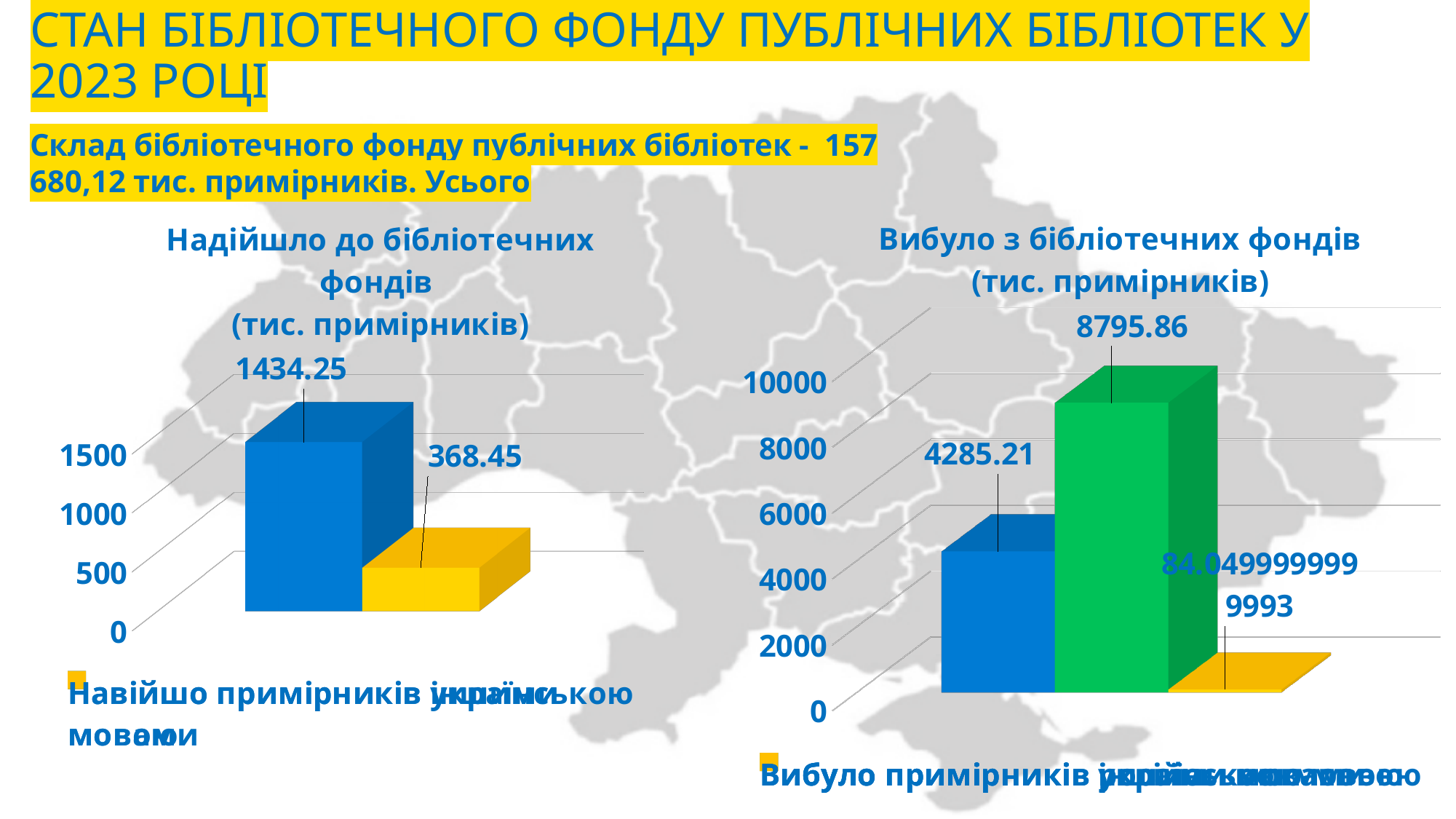
In the right chart (Вибуло з бібліотечних фондів), what is the difference between the green bar and the blue bar? 4510.65 What type of chart is the left chart (Надійшло до бібліотечних фондів)? Bar chart In the right chart (Вибуло з бібліотечних фондів), is the value of the yellow bar greater or less than 2000? less In the left chart (Надійшло до бібліотечних фондів), what is the value of the yellow bar? 368.45 In the left chart (Надійшло до бібліотечних фондів), how many bars are plotted? 2 In the right chart (Вибуло з бібліотечних фондів), how many bars are plotted? 3 In the left chart (Надійшло до бібліотечних фондів), what is the value of the blue bar? 1434.25 In the right chart (Вибуло з бібліотечних фондів), which coloured bar is the lowest? Yellow In the right chart (Вибуло з бібліотечних фондів), what is the value of the green bar? 8795.86 In the left chart (Надійшло до бібліотечних фондів), what is the difference between the blue bar and the yellow bar? 1065.80 In the right chart (Вибуло з бібліотечних фондів), what is the value of the blue bar? 4285.21 In the right chart (Вибуло з бібліотечних фондів), which coloured bar is the highest? Green